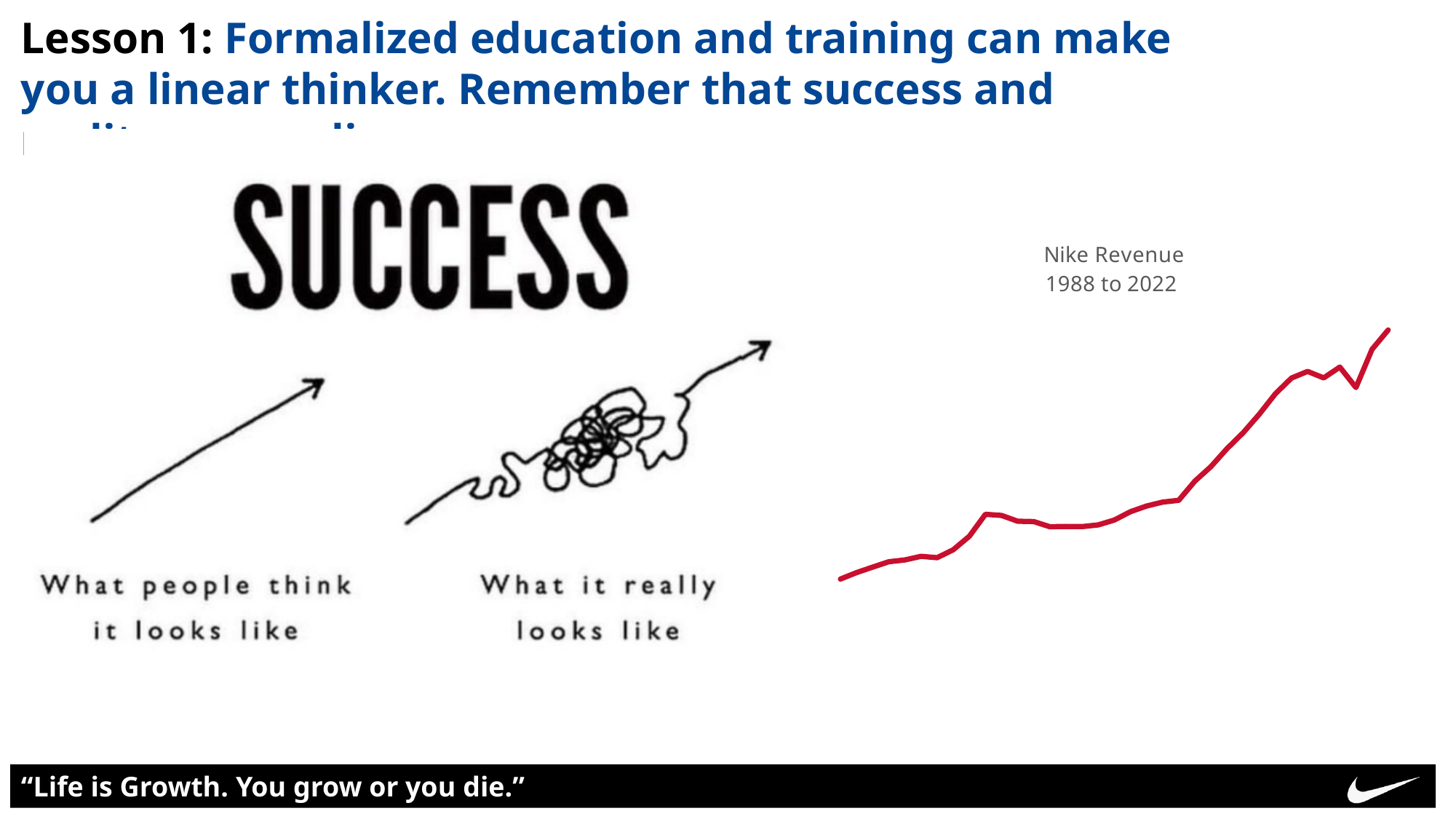
What colour is the line in the Nike Revenue chart? red What kind of chart is the Nike Revenue chart on the right of the slide? line chart What is the title of the chart on the right of the slide? Nike Revenue 1988 to 2022 What period does the Nike Revenue chart cover? 1988 to 2022 In the Nike Revenue chart, do the values generally rise or fall from 1988 to 2022? rise